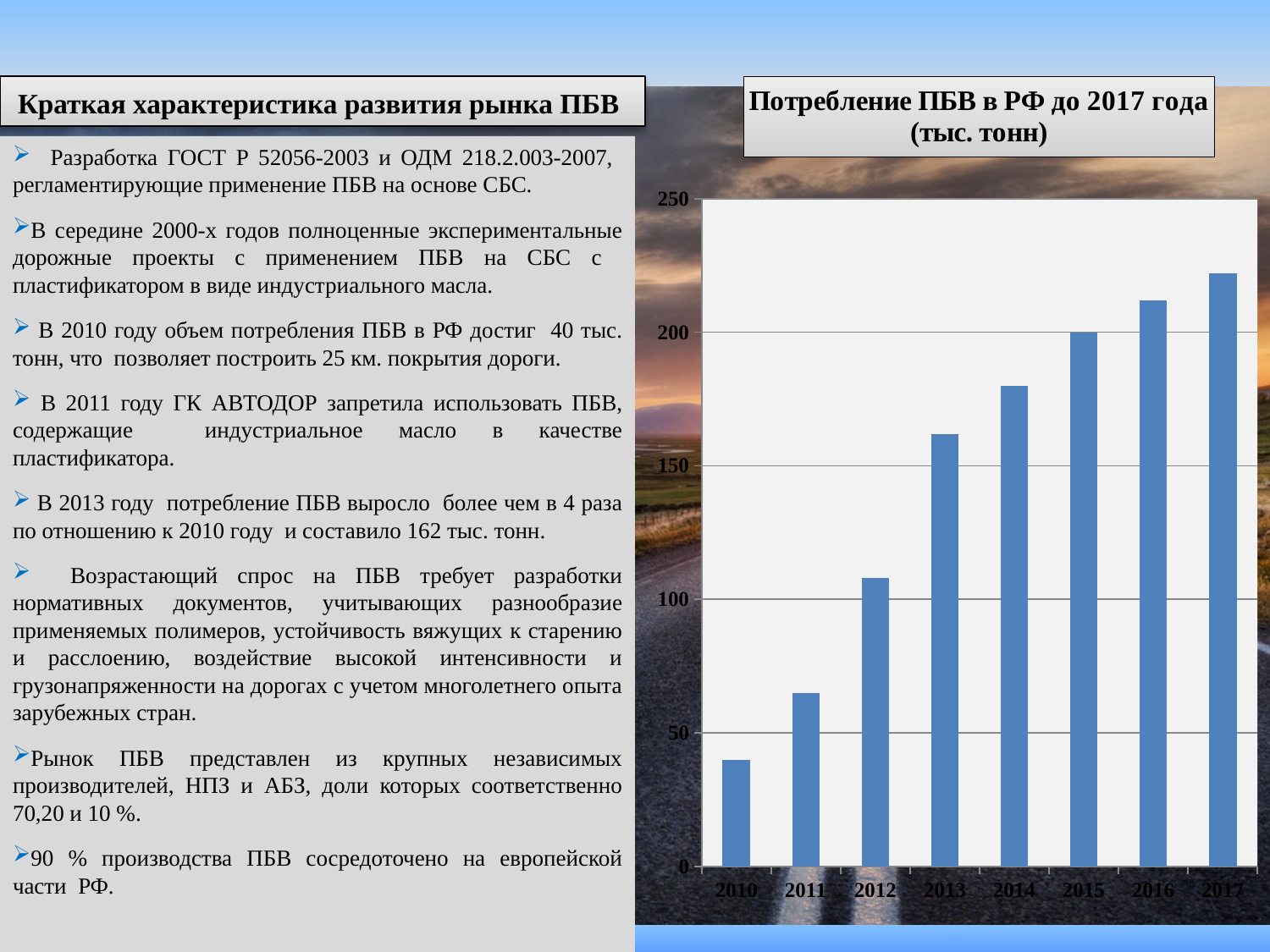
Which year has the larger value, 2012 or 2014? 2014 Do the values rise or fall from 2010 to 2017? rise Is the value for 2013 greater or less than 150? greater How many years are plotted on the x axis of the chart? 8 Is the value for 2010 greater or less than 50? less What is the title of the chart? Потребление ПБВ в РФ до 2017 года (тыс. тонн) Is the value for 2014 greater or less than 200? less Which year has the highest value in the chart? 2017 Which year has the lowest value in the chart? 2010 What kind of chart is shown on the slide? bar chart